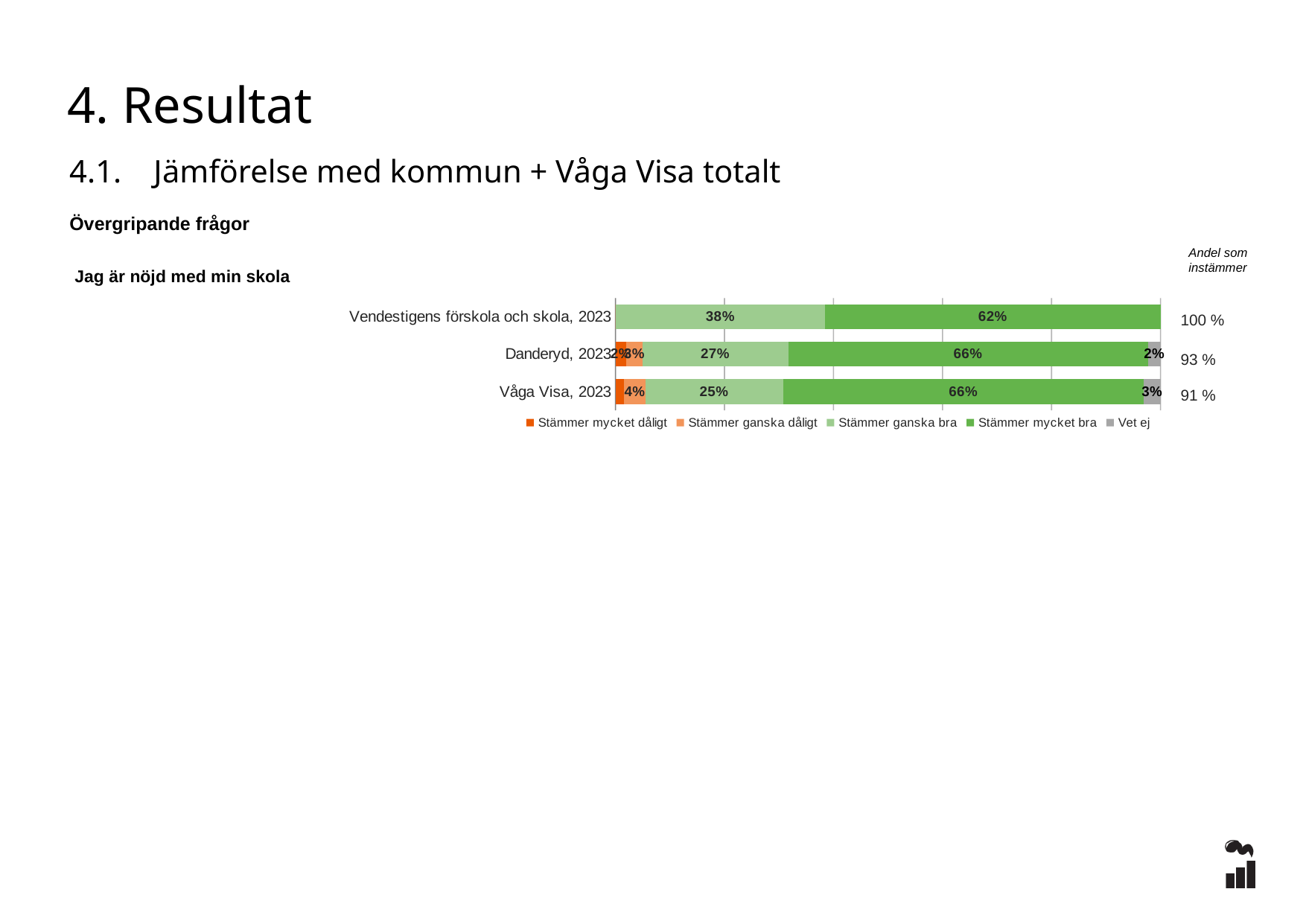
What is the 'Stämmer mycket bra' value for Våga Visa, 2023? 66% Which is larger: the 'Stämmer mycket bra' value for Danderyd, 2023 or for Vendestigens förskola och skola, 2023? Danderyd, 2023 What kind of chart is shown on the slide? stacked bar chart How many categories (rows) are plotted in the chart? 3 Which category has the highest 'Stämmer ganska bra' value? Vendestigens förskola och skola, 2023 What is the 'Vet ej' value for Våga Visa, 2023? 3% What is the 'Stämmer ganska bra' value for Vendestigens förskola och skola, 2023? 38% What is the 'Stämmer mycket bra' value for Vendestigens förskola och skola, 2023? 62% What is the 'Andel som instämmer' value shown for Danderyd, 2023? 93 % What is the difference between the 'Stämmer ganska bra' values for Vendestigens förskola och skola, 2023 and Våga Visa, 2023? 13% What is the 'Stämmer ganska bra' value for Danderyd, 2023? 27% How many series does the legend list? 5